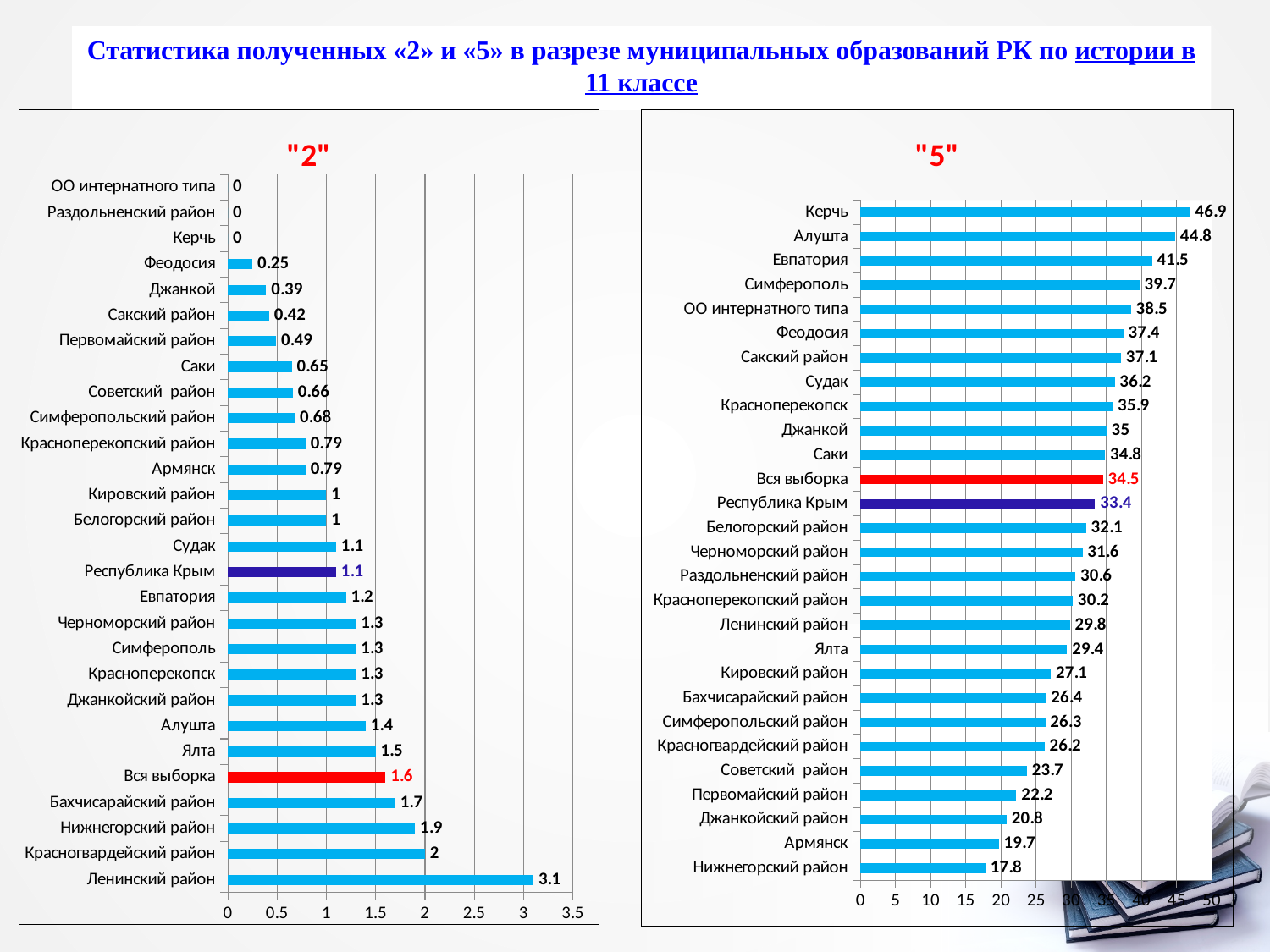
How many categories are shown in the "5" chart? 28 In the "5" chart, which is larger, the value for Ялта or the value for Армянск? Ялта In the "2" chart, how many categories have a value of 0? 3 What kind of chart is the "2" chart? bar chart In the "2" chart, what is the value for Вся выборка? 1.6 In the "2" chart, what is the difference between the values for Ленинский район and Красногвардейский район? 1.1 In the "2" chart, which category has the highest value? Ленинский район In the "5" chart, what is the value for Керчь? 46.9 In the "5" chart, which category has the lowest value? Нижнегорский район In the "5" chart, what is the difference between the values for Керчь and Алушта? 2.1 In the "5" chart, what is the value for Республика Крым? 33.4 In the "2" chart, what is the value for Ленинский район? 3.1